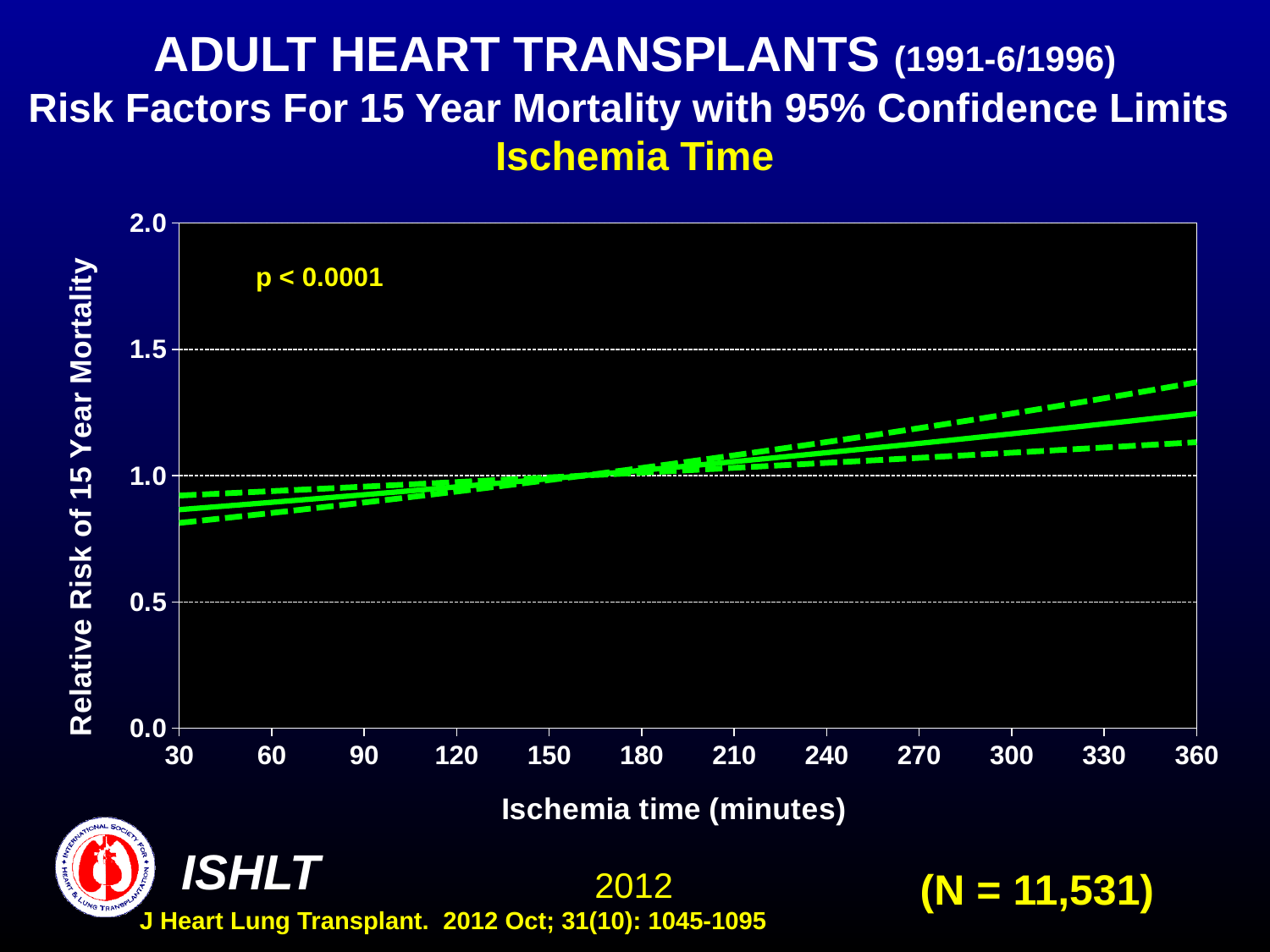
How many tick labels are shown on the x axis of the chart? 12 Is the relative risk of 15 year mortality at an ischemia time of 30 minutes greater or less than 1.0? less Is the relative risk of 15 year mortality at an ischemia time of 90 minutes greater or less than 1.0? less Is the upper 95% confidence limit at an ischemia time of 360 minutes greater or less than 1.5? less How many lines are plotted on the chart (including the confidence limits)? 3 What kind of chart is shown on the slide? line chart Does the relative risk of 15 year mortality rise or fall as ischemia time increases along the x axis? rise What p-value is printed on the chart? p < 0.0001 What is the label of the x axis of the chart? Ischemia time (minutes)